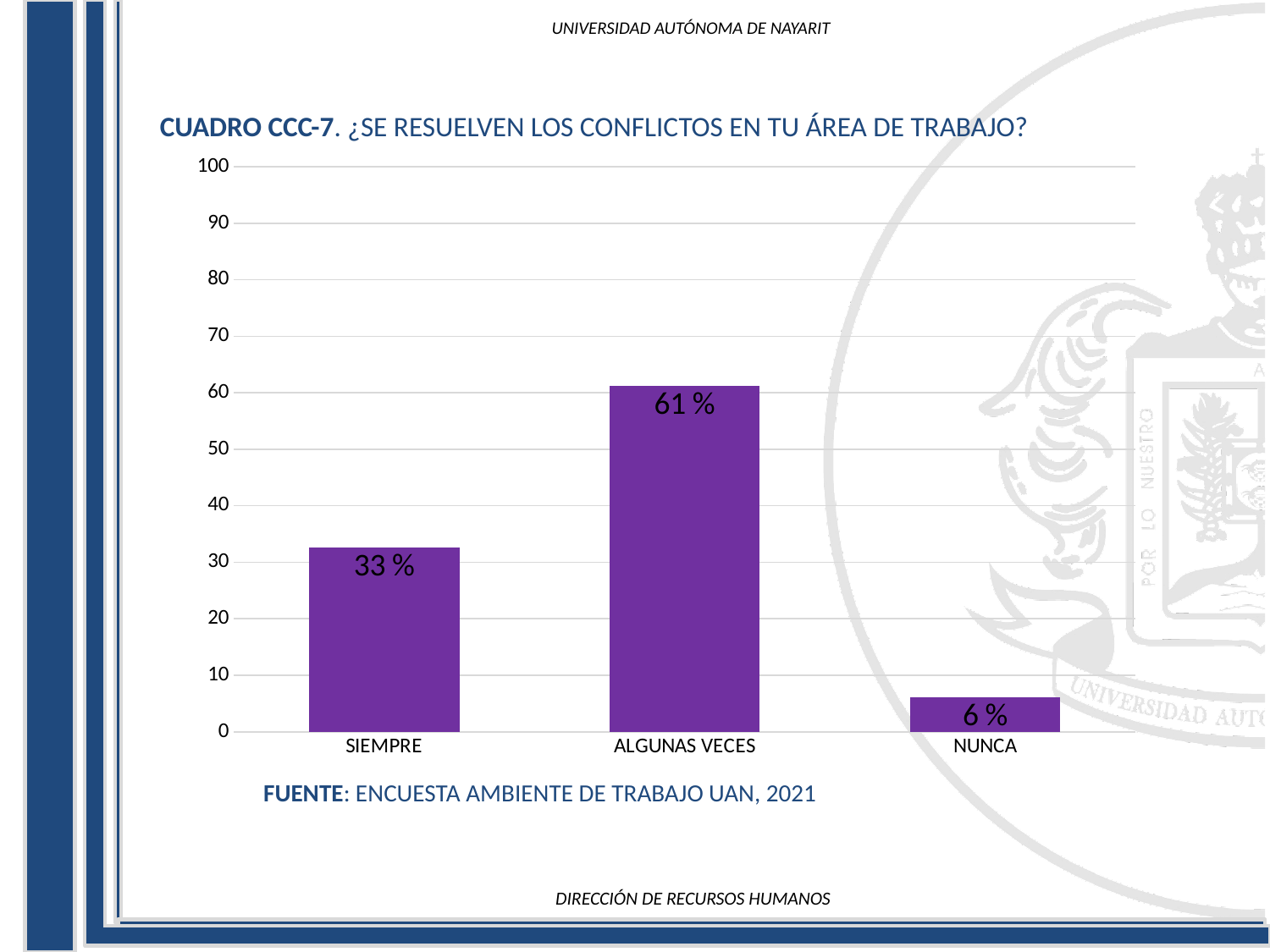
What kind of chart is shown on the slide? bar chart Which category has the highest value? ALGUNAS VECES What is the value for SIEMPRE? 33 % What is the value for NUNCA? 6 % What is the difference between the values for SIEMPRE and NUNCA? 27 % Which is larger, the value for SIEMPRE or the value for NUNCA? SIEMPRE What is the difference between the values for ALGUNAS VECES and SIEMPRE? 28 % What source is cited below the chart? ENCUESTA AMBIENTE DE TRABAJO UAN, 2021 How many categories are shown on the x axis? 3 What is the value for ALGUNAS VECES? 61 % Is the value for ALGUNAS VECES greater or less than 50? greater Which category has the lowest value? NUNCA